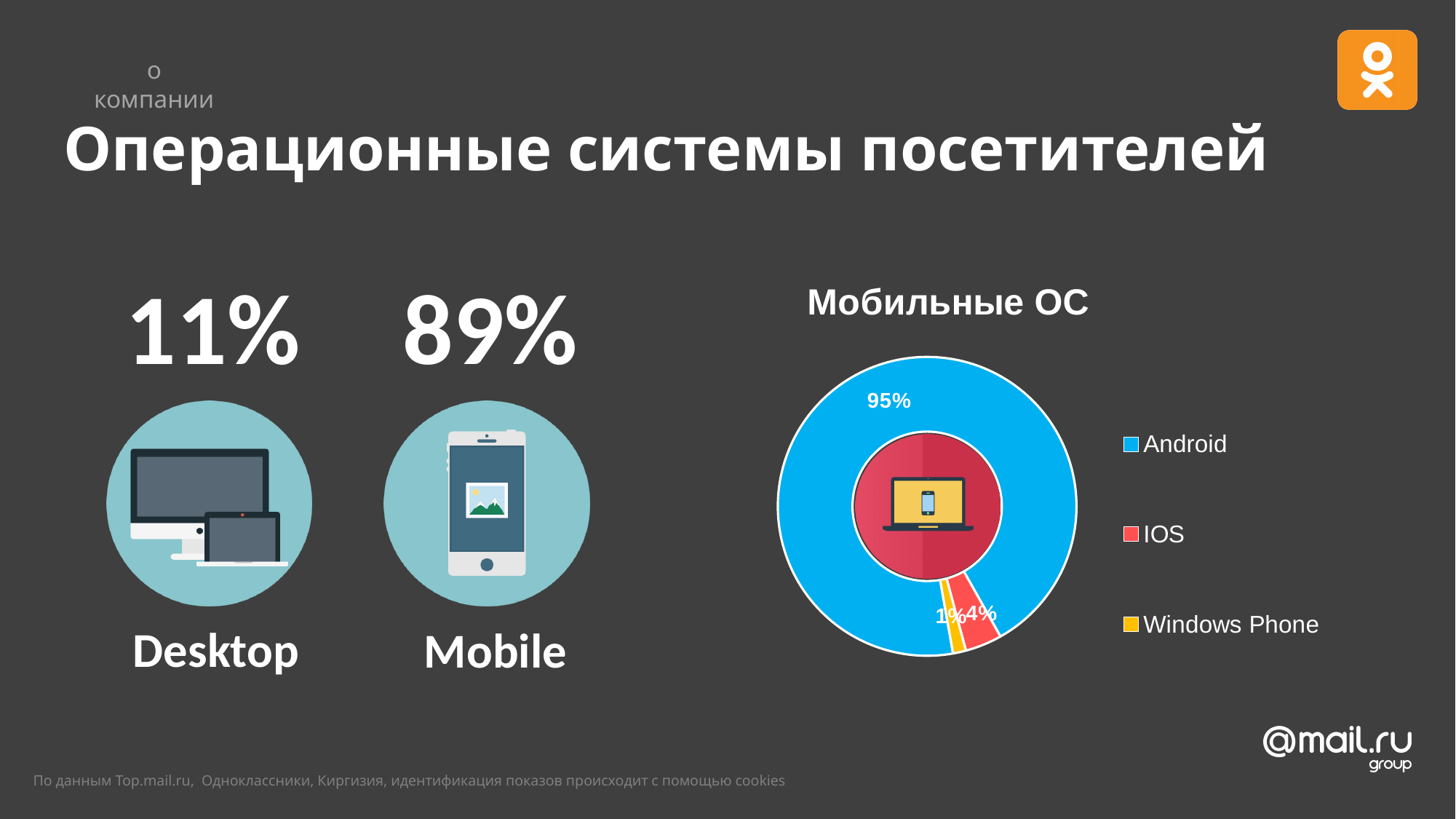
In the 'Мобильные ОС' chart, what share does Windows Phone have? 1% In the 'Мобильные ОС' chart, what share does IOS have? 4% In the 'Мобильные ОС' chart, how many percentage points larger is IOS's share than Windows Phone's share? 3 How many categories does the 'Мобильные ОС' chart show? 3 In the 'Мобильные ОС' chart, which colour represents Android in the legend? Blue In the 'Мобильные ОС' chart, which mobile OS has the largest share? Android What kind of chart is the 'Мобильные ОС' chart? Doughnut chart What is the title of the pie chart on the slide? Мобильные ОС In the 'Мобильные ОС' chart, which mobile OS has the smallest share? Windows Phone In the 'Мобильные ОС' chart, how many percentage points larger is Android's share than IOS's share? 91 In the 'Мобильные ОС' chart, which has a larger share, IOS or Windows Phone? IOS In the 'Мобильные ОС' chart, what share does Android have? 95%